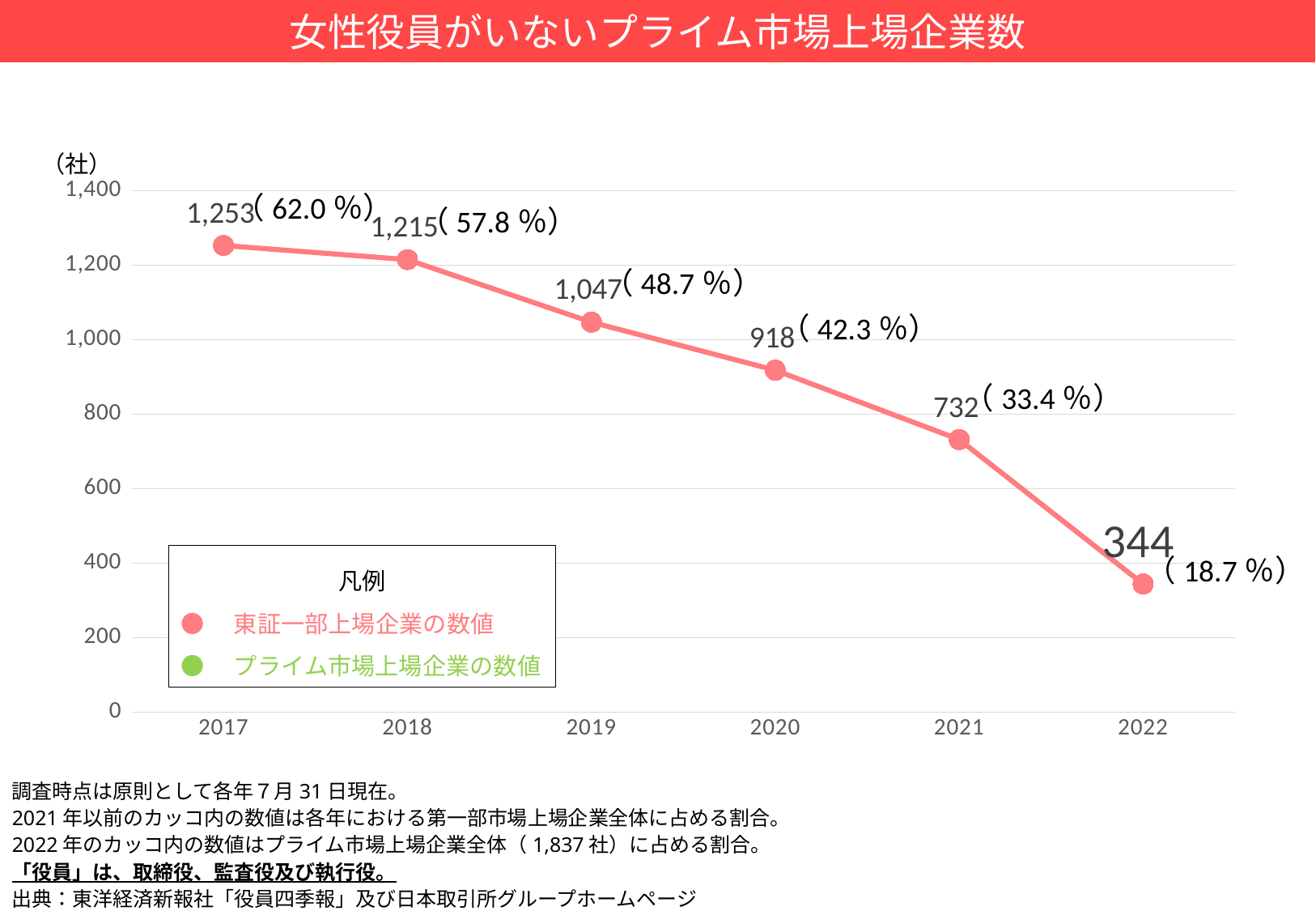
What is the value for 2022? 344 Which year has the lowest value? 2022 What percentage is shown in parentheses for 2019? 48.7 % Which year has the highest value? 2017 What is the value for 2020? 918 What is the value for 2017? 1,253 Is the value for 2021 greater or less than 800? less What is the difference between the values for 2021 and 2022? 388 Do the values rise or fall from 2017 to 2022? fall How many years are plotted on the x axis? 6 How many entries does the legend list? 2 Which is larger, the value for 2018 or the value for 2019? 2018